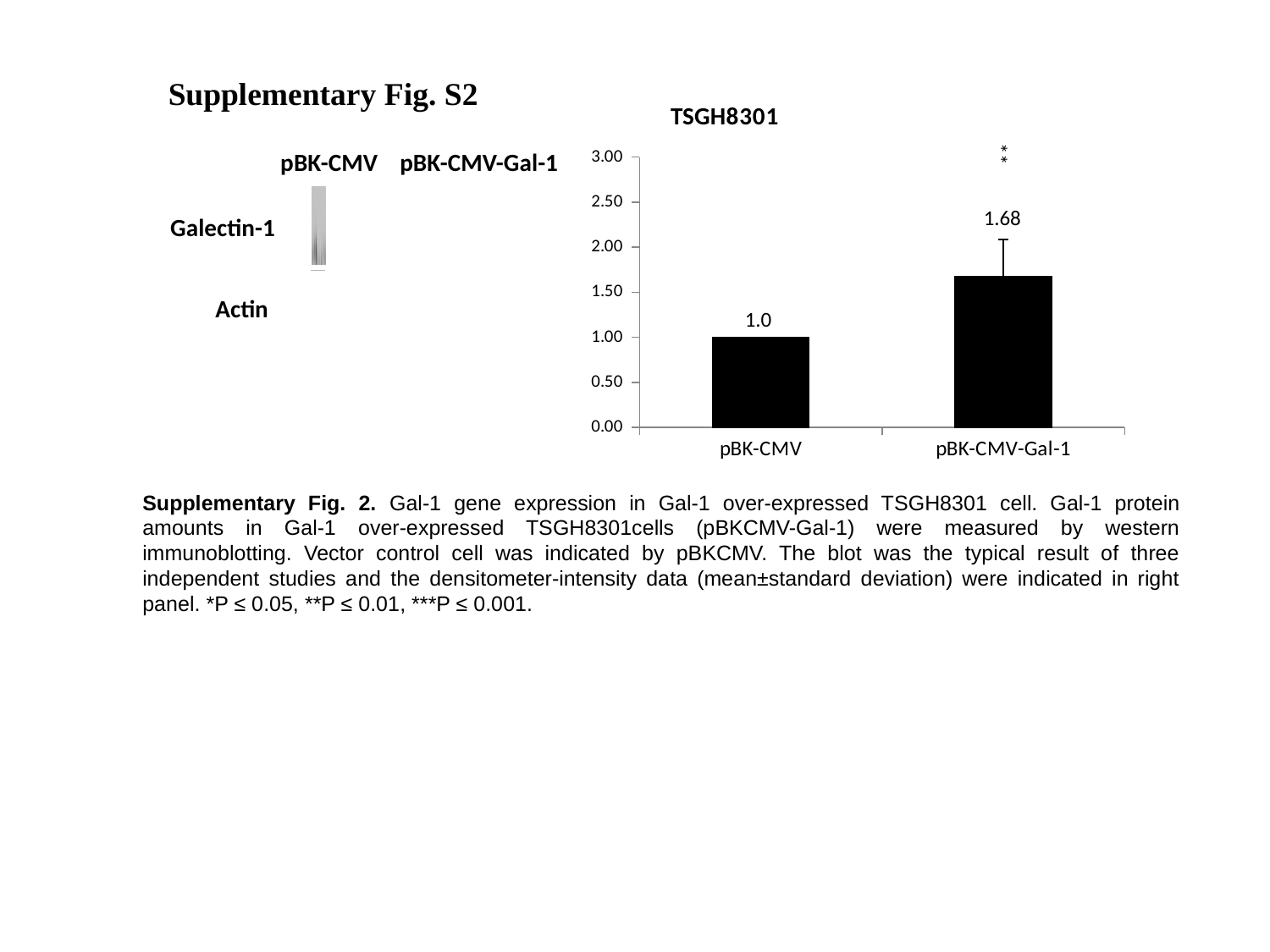
Is the value for pBK-CMV in the TSGH8301 chart greater or less than 1.50? less What is the value for pBK-CMV-Gal-1 in the TSGH8301 chart? 1.68 What is the title of the bar chart on the slide? TSGH8301 In the TSGH8301 chart, which is larger: the value for pBK-CMV or for pBK-CMV-Gal-1? pBK-CMV-Gal-1 Is the value for pBK-CMV-Gal-1 in the TSGH8301 chart greater or less than 1.50? greater How many categories are shown on the x axis of the TSGH8301 chart? 2 Which category has the lowest value in the TSGH8301 chart? pBK-CMV What is the maximum value shown on the y axis of the TSGH8301 chart? 3.00 What kind of chart is the TSGH8301 chart? bar chart What is the difference between the pBK-CMV-Gal-1 and pBK-CMV values in the TSGH8301 chart? 0.68 What is the value for pBK-CMV in the TSGH8301 chart? 1.0 Which category has the highest value in the TSGH8301 chart? pBK-CMV-Gal-1